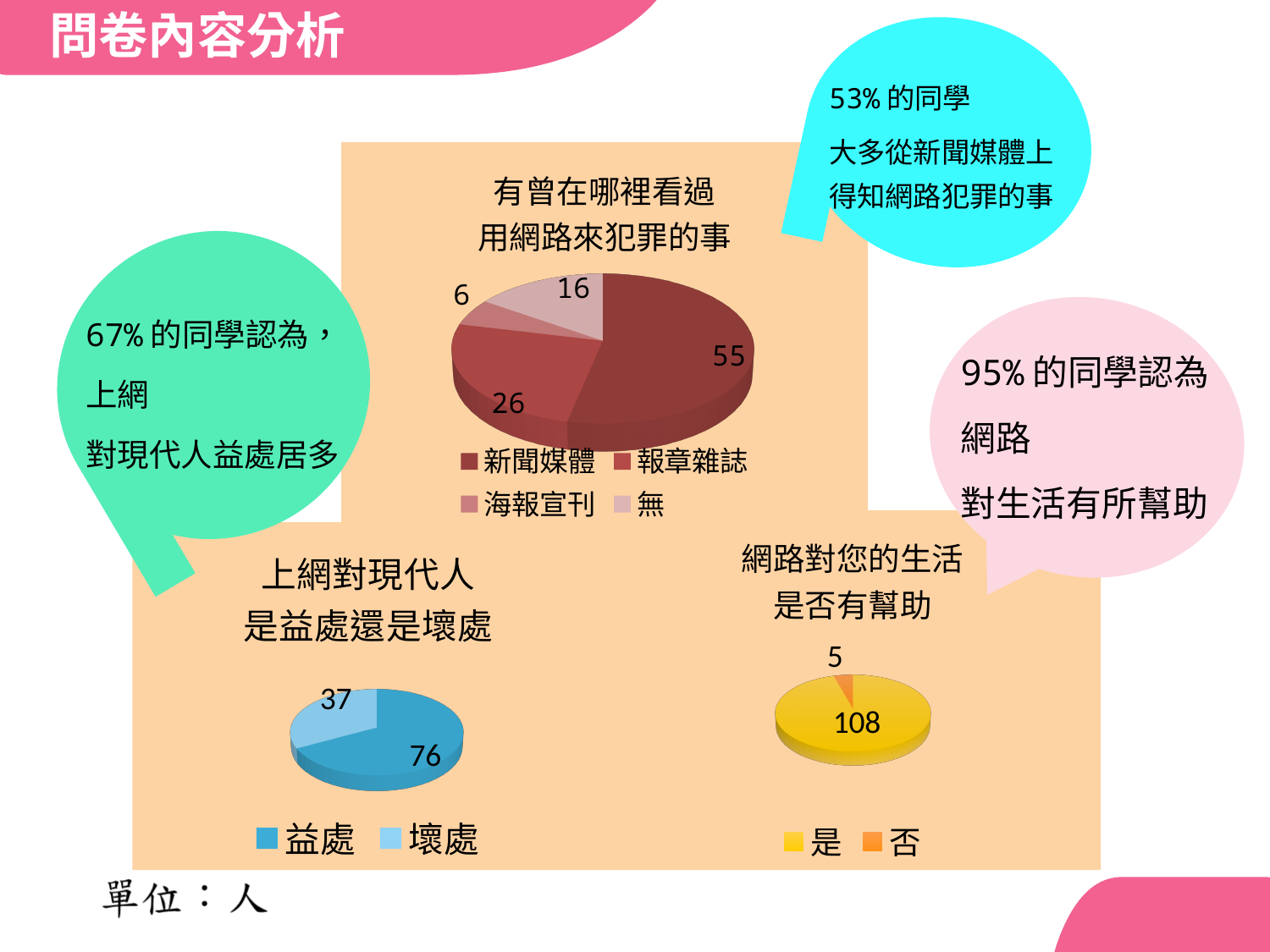
In the bottom-right chart titled 網路對您的生活是否有幫助, which is larger, 是 or 否? 是 What kind of chart is the bottom-right chart titled 網路對您的生活是否有幫助? Pie chart In the top chart titled 有曾在哪裡看過用網路來犯罪的事, how many categories does the legend list? 4 In the top chart titled 有曾在哪裡看過用網路來犯罪的事, what is the difference between 報章雜誌 and 無? 10 In the bottom-left chart titled 上網對現代人是益處還是壞處, what is the total of the two slices? 113 In the top chart titled 有曾在哪裡看過用網路來犯罪的事, which category has the smallest value? 海報宣刊 In the top chart titled 有曾在哪裡看過用網路來犯罪的事, what is the value for 新聞媒體? 55 In the top chart titled 有曾在哪裡看過用網路來犯罪的事, which category has the largest value? 新聞媒體 In the bottom-left chart titled 上網對現代人是益處還是壞處, what is the value for 壞處? 37 In the bottom-right chart titled 網路對您的生活是否有幫助, what is the value for 否? 5 In the top chart titled 有曾在哪裡看過用網路來犯罪的事, what share of the total does 新聞媒體 represent? 53% In the bottom-left chart titled 上網對現代人是益處還是壞處, what share of the total does 益處 represent? 67%